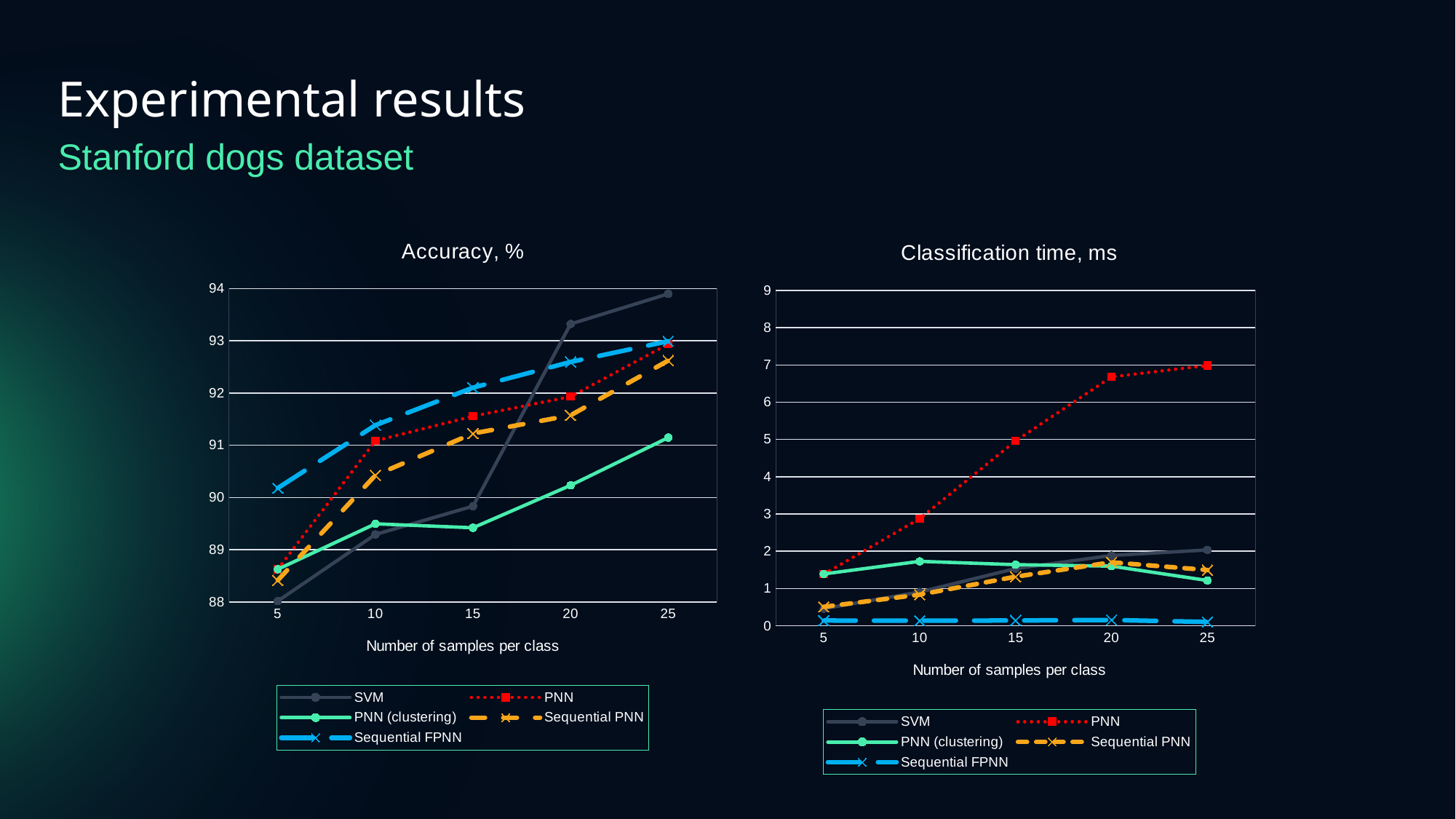
How many x-axis points (numbers of samples per class) are plotted in the 'Accuracy, %' chart? 5 In the 'Classification time, ms' chart, which series has the highest classification time at 25 samples per class? PNN How many series does the legend of the 'Classification time, ms' chart list? 5 In the 'Classification time, ms' chart, which series has the lowest classification time at 25 samples per class? Sequential FPNN In the 'Accuracy, %' chart, which series has the lowest accuracy at 25 samples per class? PNN (clustering) What kind of chart is the 'Accuracy, %' chart? line chart In the 'Classification time, ms' chart, is the PNN value at 25 samples per class greater or less than 6? greater In the 'Accuracy, %' chart, which series has the lowest accuracy at 5 samples per class? SVM In the 'Accuracy, %' chart, is the SVM value at 5 samples per class greater or less than 89? less In the 'Accuracy, %' chart, which series has the highest accuracy at 25 samples per class? SVM In the 'Accuracy, %' chart, is the SVM value at 25 samples per class greater or less than 93? greater In the 'Classification time, ms' chart, does the PNN classification time rise or fall as the number of samples per class increases? rise